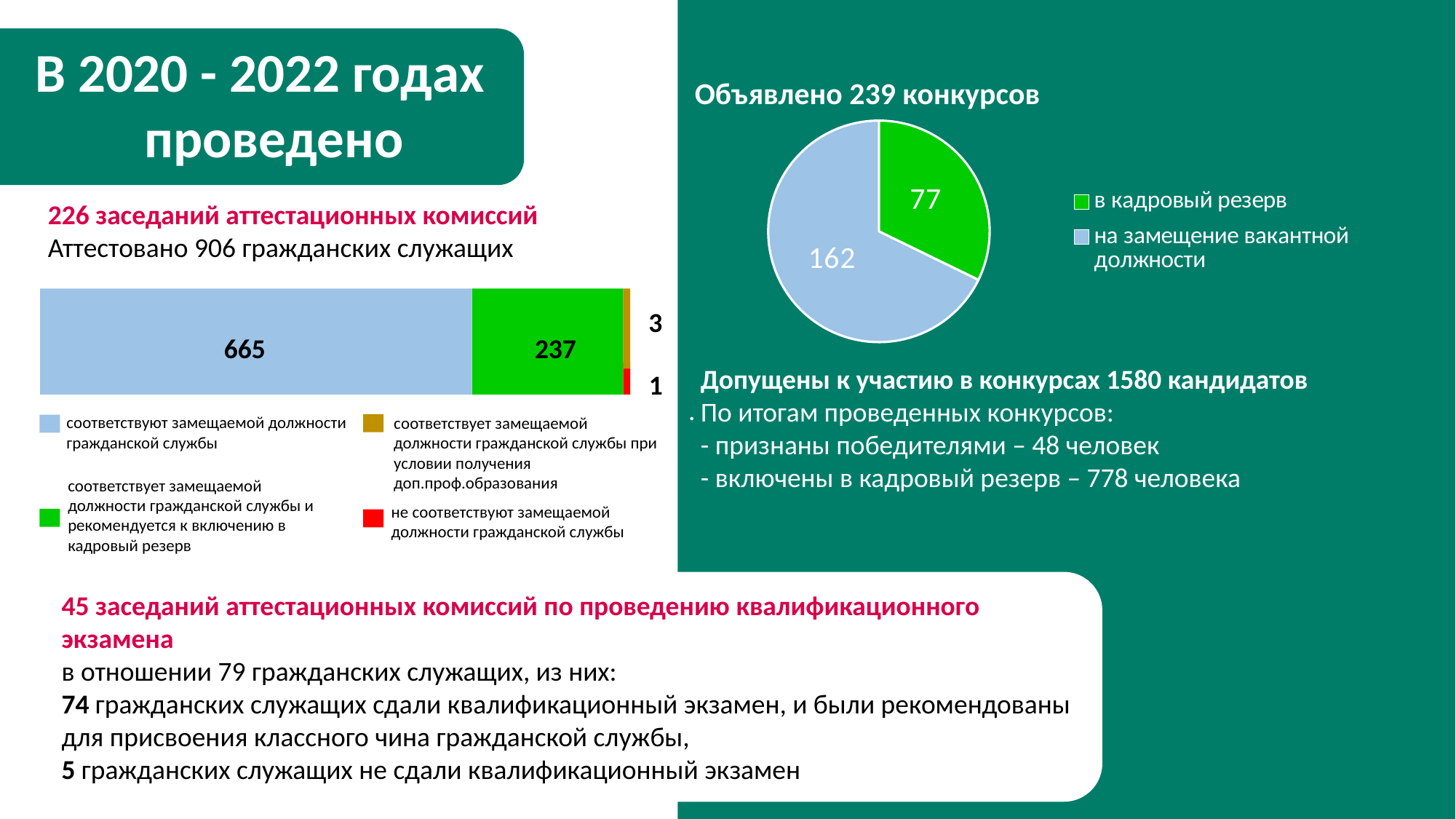
In the pie chart 'Объявлено 239 конкурсов', which slice is larger: 'в кадровый резерв' or 'на замещение вакантной должности'? на замещение вакантной должности In the bar chart on the left, which category has the smallest value? не соответствуют замещаемой должности гражданской службы What kind of chart is the chart titled 'Объявлено 239 конкурсов'? pie chart In the bar chart on the left, what is the value for 'соответствуют замещаемой должности гражданской службы'? 665 In the bar chart on the left, what is the difference between the values 665 and 237? 428 What kind of chart is the chart on the left under 'Аттестовано 906 гражданских служащих'? bar chart In the pie chart 'Объявлено 239 конкурсов', what is the difference between the two slices? 85 In the bar chart on the left, what is the value for 'соответствует замещаемой должности гражданской службы и рекомендуется к включению в кадровый резерв'? 237 In the pie chart 'Объявлено 239 конкурсов', what is the value for 'в кадровый резерв'? 77 In the bar chart on the left, what is the value for 'не соответствуют замещаемой должности гражданской службы'? 1 In the bar chart on the left, what is the total of all segments of the stacked bar? 906 How many entries does the legend of the bar chart on the left list? 4